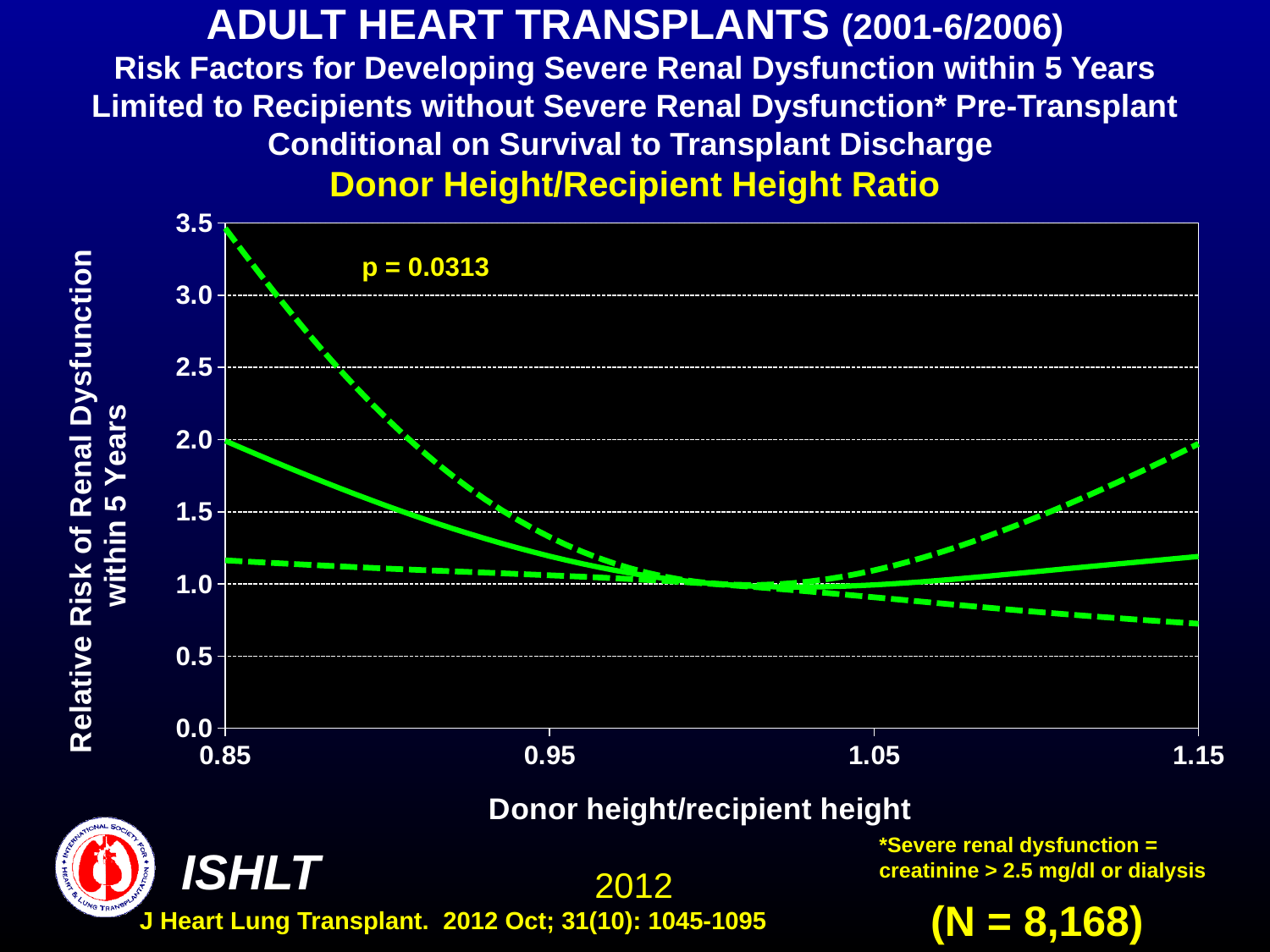
Is the value of the upper dashed line at a ratio of 1.15 greater or less than 1.5? greater Is the value of the upper dashed line at a ratio of 0.85 greater or less than 3.0? greater What is the label of the x axis of the chart? Donor height/recipient height How many lines are plotted on the chart? 3 At a ratio of 0.85, which line has the larger value: the solid line or the lower dashed line? the solid line Does the lower dashed line rise or fall as the donor height/recipient height ratio increases from 1.00 to 1.15? fall Does the solid line rise or fall as the donor height/recipient height ratio increases from 0.85 to 1.00? fall Is the value of the solid line at a ratio of 0.95 greater or less than 1.5? less Does the upper dashed line rise or fall as the donor height/recipient height ratio increases from 1.00 to 1.15? rise What p-value is printed on the chart? p = 0.0313 What kind of chart is shown on the slide? line chart